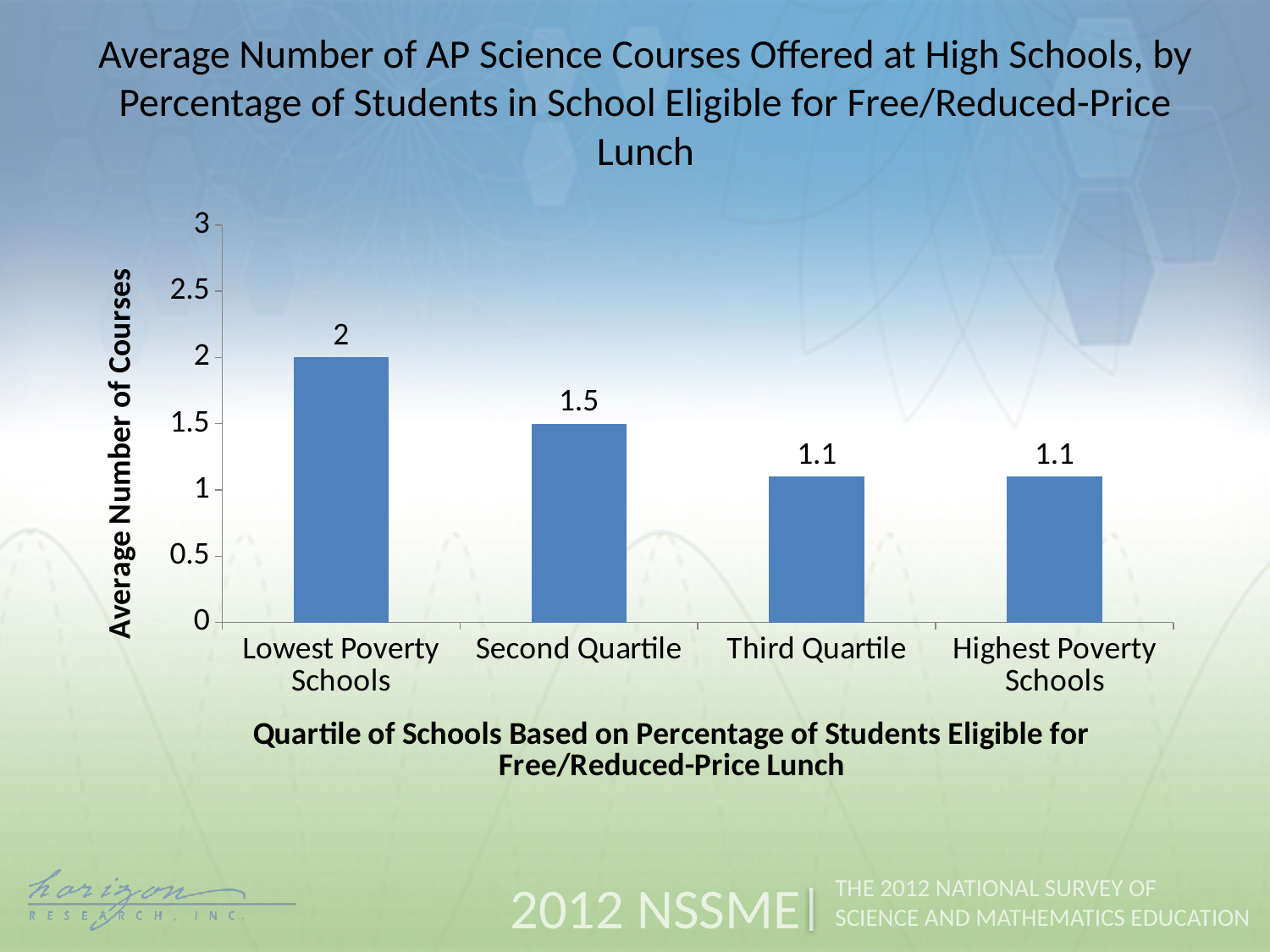
Do the values generally rise or fall from Lowest Poverty Schools to Highest Poverty Schools? Fall Which quartile has the highest average number of AP science courses? Lowest Poverty Schools What is the average number of AP science courses offered at Highest Poverty Schools? 1.1 What is the average number of AP science courses offered at Lowest Poverty Schools? 2 What is the difference in average number of courses between Lowest Poverty Schools and Highest Poverty Schools? 0.9 What is the difference in average number of courses between Lowest Poverty Schools and Second Quartile schools? 0.5 What is the average number of AP science courses offered at Second Quartile schools? 1.5 What is the label of the vertical axis? Average Number of Courses What kind of chart is shown on the slide? Bar chart What is the average number of AP science courses offered at Third Quartile schools? 1.1 Which has a larger average number of courses, Second Quartile or Third Quartile? Second Quartile How many quartile categories are shown on the chart? 4